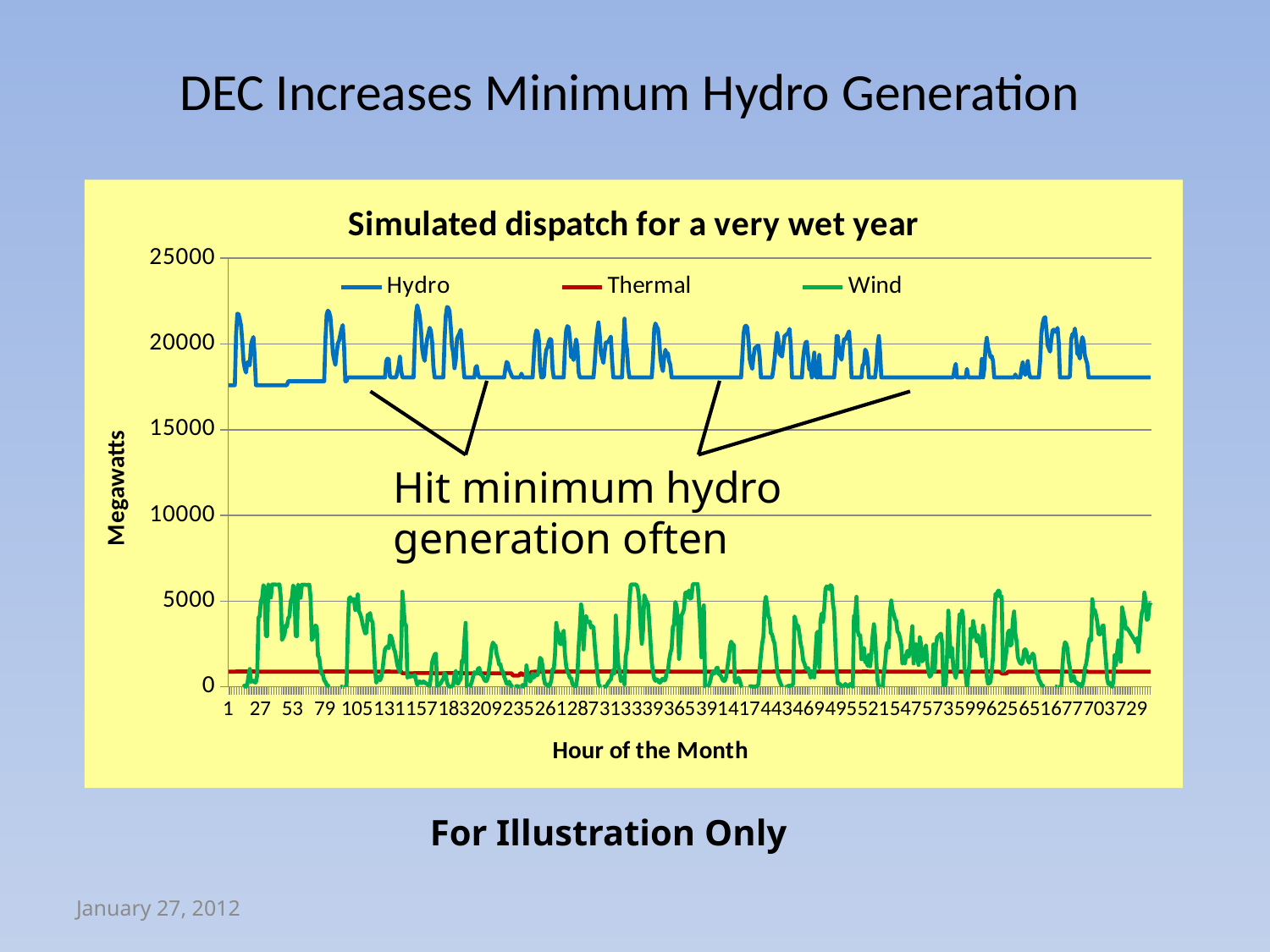
What is the title of the chart? Simulated dispatch for a very wet year Which is larger at hour 729, the Hydro value or the Wind value? Hydro Which series has the lowest values across the chart? Thermal Is the Wind value at hour 1 greater or less than 5000? less How many series does the legend list? 3 What kind of chart is shown on the slide? line chart Which series has the highest values across the chart? Hydro Is the Hydro value at hour 729 greater or less than 10000? greater Is the Thermal value at hour 1 greater or less than 5000? less Which is larger at hour 1, the Thermal value or the Hydro value? Hydro What is the label of the vertical axis? Megawatts